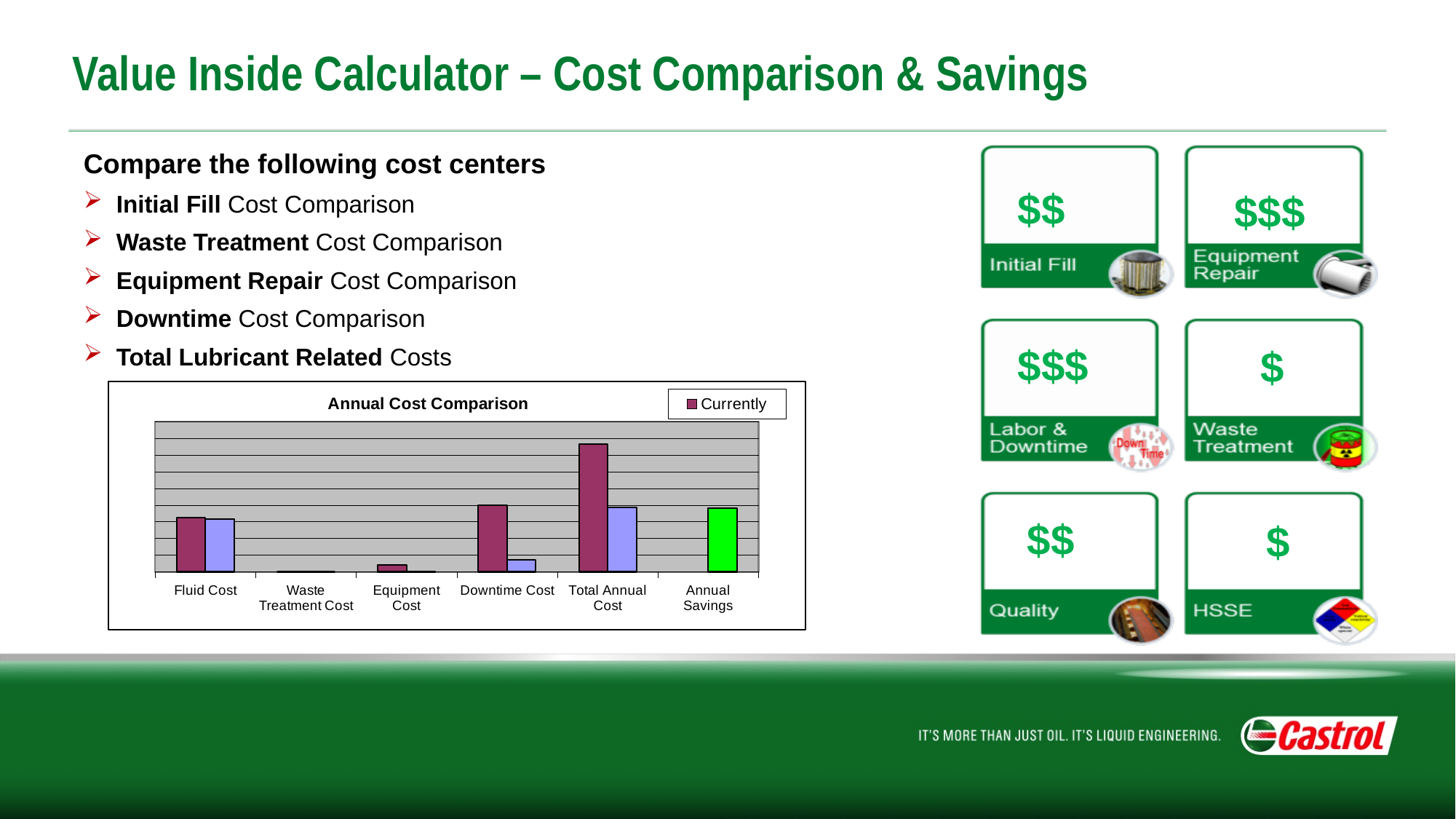
For the Currently series, which is larger: Fluid Cost or Equipment Cost? Fluid Cost What is the title of the chart? Annual Cost Comparison Which category has the tallest bar for the Currently series? Total Annual Cost Which category is the first one on the x axis of the chart? Fluid Cost For the Currently series, which is larger: Total Annual Cost or Downtime Cost? Total Annual Cost How many categories are shown on the x axis of the chart? 6 What series name does the chart's legend list? Currently Which category is the last one on the x axis of the chart? Annual Savings What kind of chart is shown on the slide? bar chart Which category has the lowest bar for the Currently series? Waste Treatment Cost